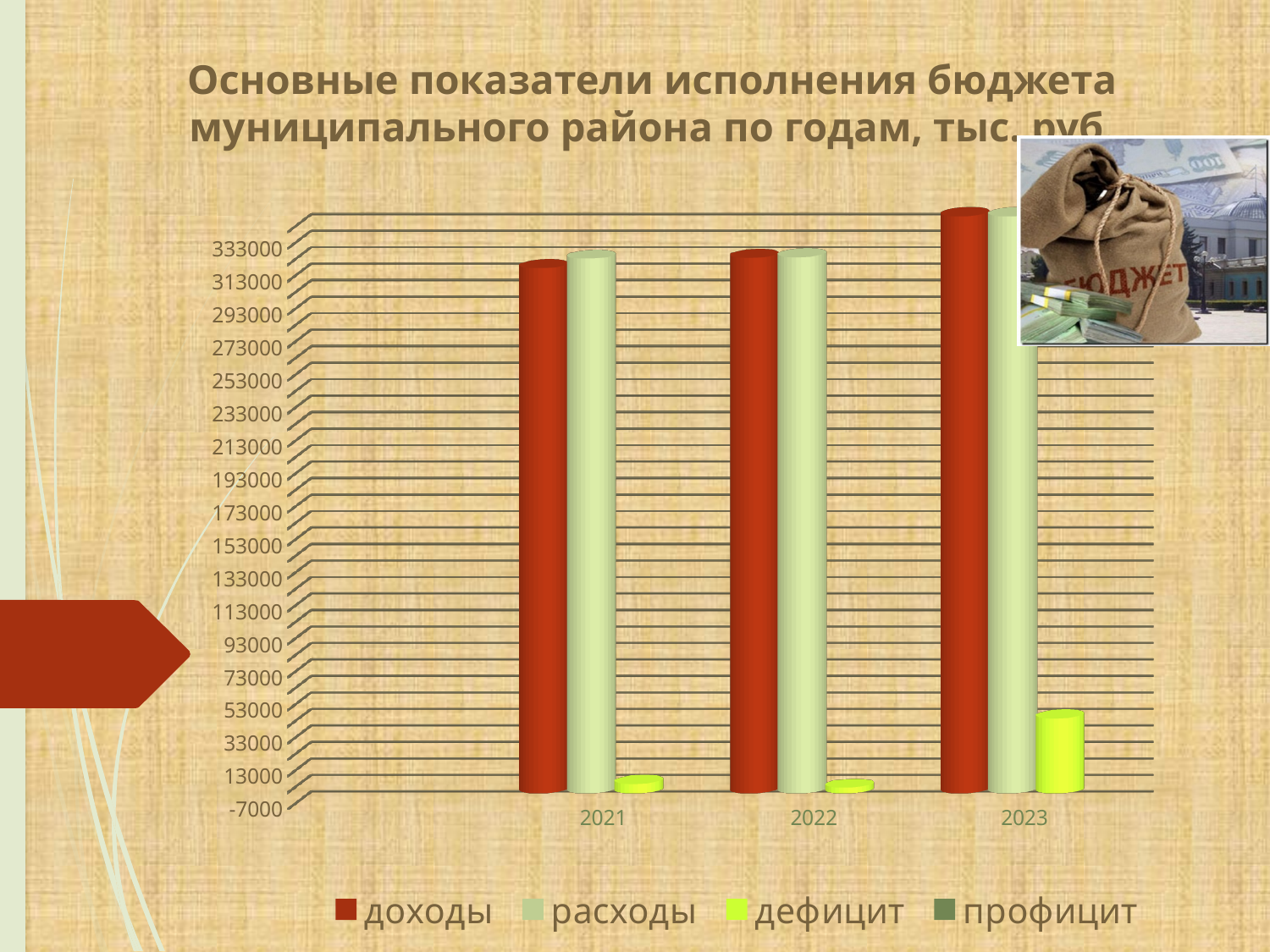
Is the value for дефицит in 2023 greater or less than 33000? greater Is the value for доходы in 2021 greater or less than 293000? greater Do the values for доходы rise or fall from 2021 to 2023? rise Which year has the highest value for доходы? 2023 Which is larger: дефицит in 2023 or дефицит in 2021? дефицит in 2023 Is the value for дефицит in 2021 greater or less than 13000? less Which year has the highest value for дефицит? 2023 How many series does the legend list? 4 What kind of chart is shown on the slide? bar chart What colour represents the доходы series in the legend? red How many years (categories) are shown on the x axis? 3